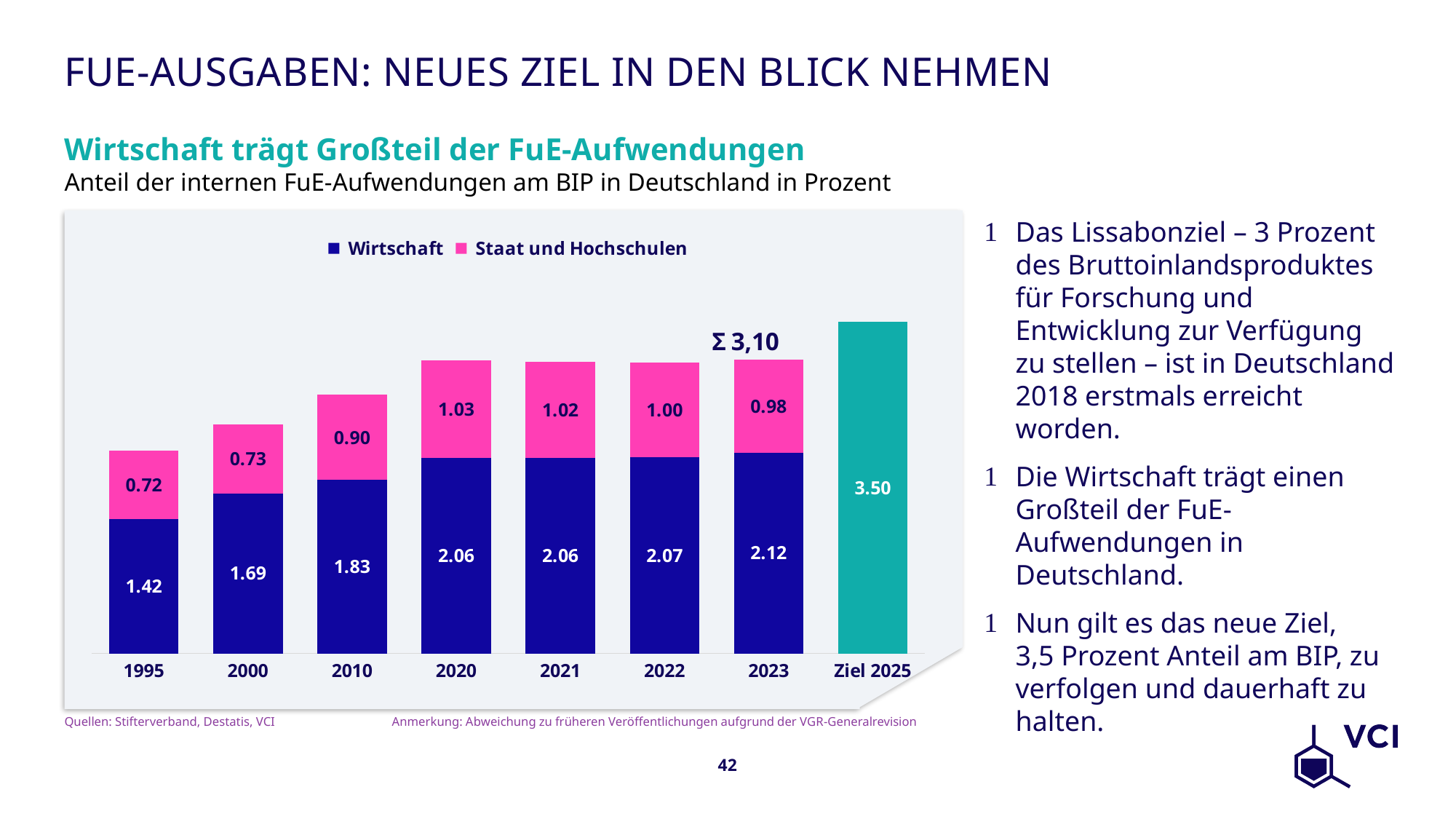
What is the value for Wirtschaft in 2010? 1.83 How many categories are shown on the x axis? 8 What is the value for Staat und Hochschulen in 2020? 1.03 Does the Wirtschaft value rise or fall from 1995 to 2023? rise What is the total of the stacked bar for 1995? 2.14 What value is shown for the Ziel 2025 bar? 3.50 What is the total of the stacked bar for 2023, as printed on the slide? 3,10 In which year is the Staat und Hochschulen value lowest? 1995 In which year is the Wirtschaft value highest? 2023 What is the difference between the Wirtschaft values for 2023 and 1995? 0.70 In 2000, which is larger: Wirtschaft or Staat und Hochschulen? Wirtschaft How many series does the legend list? 2